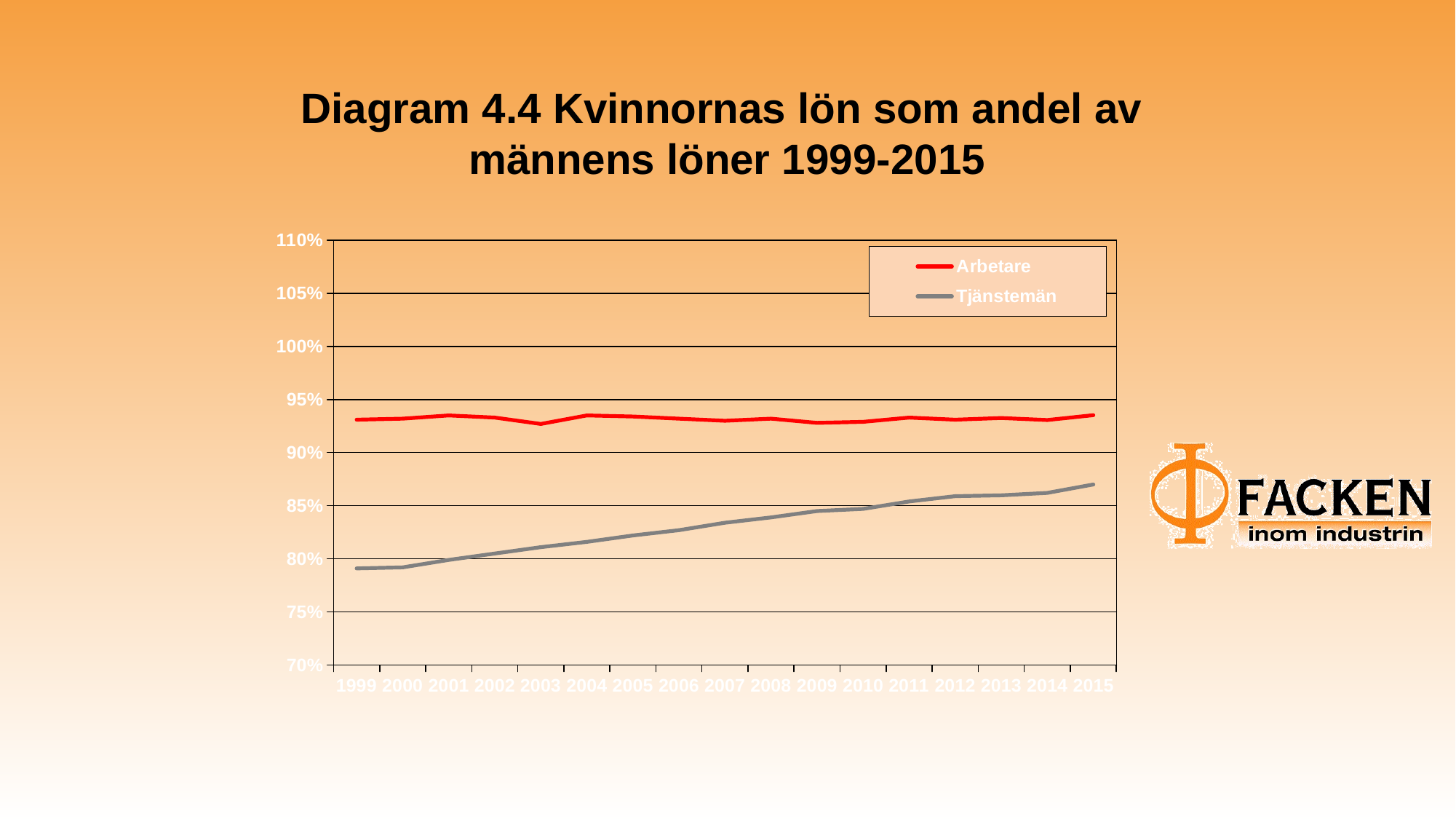
Is the value for Arbetare in 2004 greater or less than 90%? greater In which year does the Tjänstemän series reach its highest value? 2015 How many series does the legend list? 2 What kind of chart is shown on the slide? line chart Is the value for Arbetare in 2015 greater or less than 95%? less Is the value for Tjänstemän in 2015 greater or less than 85%? greater What is the title of the chart? Diagram 4.4 Kvinnornas lön som andel av männens löner 1999-2015 Which series is plotted with the red line? Arbetare How many years are plotted along the x axis? 17 Does the Tjänstemän line rise or fall from 1999 to 2015? rise In 2015, which series has the higher value, Arbetare or Tjänstemän? Arbetare